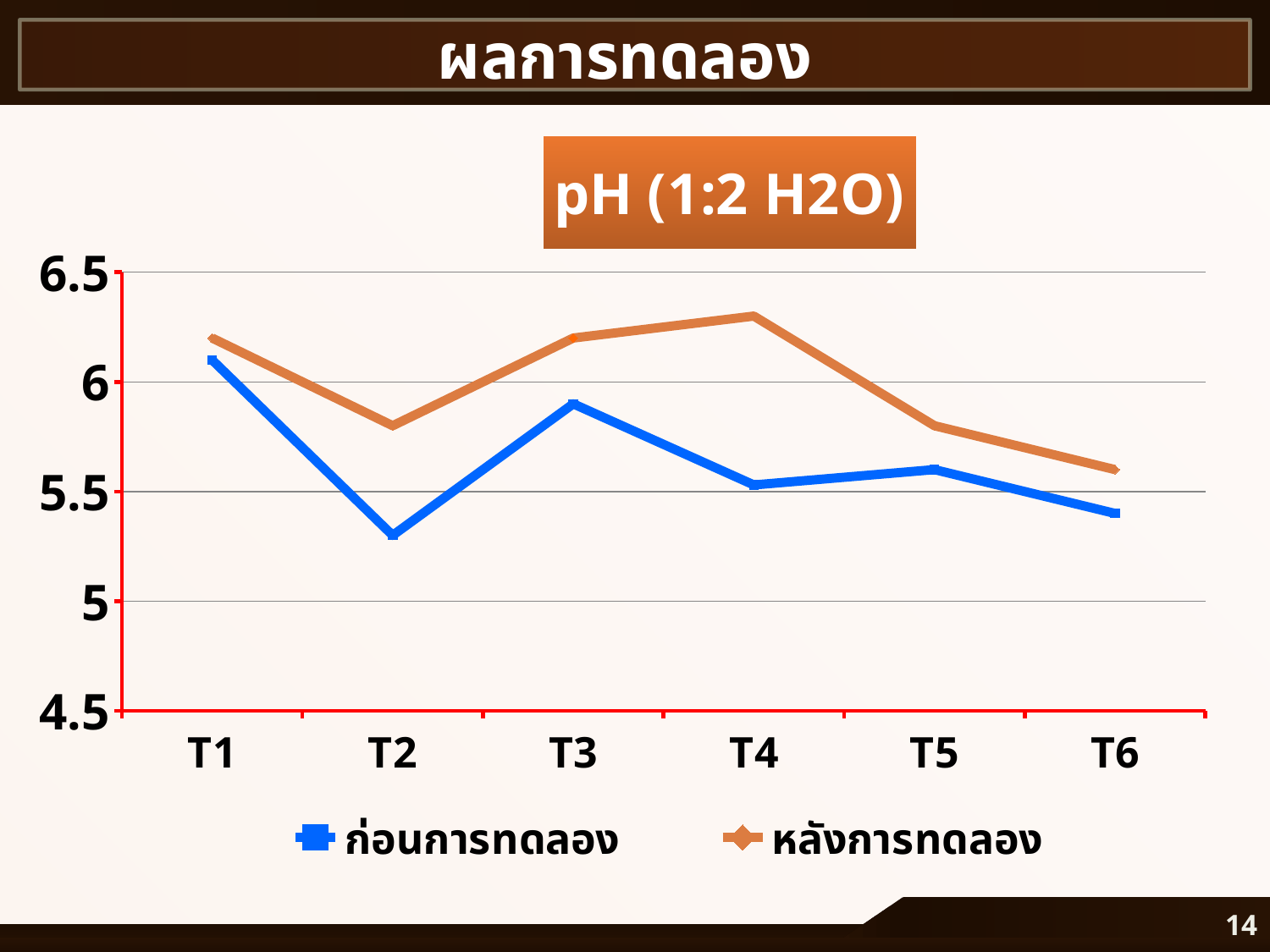
How many series does the legend list? 2 Which category has the lowest value for หลังการทดลอง? T6 Is the value for ก่อนการทดลอง at T2 greater or less than 5.5? less How many categories are shown on the x axis? 6 Is the value for หลังการทดลอง at T4 greater or less than 6? greater Does the value for หลังการทดลอง rise or fall from T4 to T6? fall What is the title of the chart? pH (1:2 H2O) What kind of chart is shown on the slide? line chart Is the value for ก่อนการทดลอง at T1 greater or less than 6? greater At T4, which series has the larger value, ก่อนการทดลอง or หลังการทดลอง? หลังการทดลอง Which category has the highest value for ก่อนการทดลอง? T1 Which category has the lowest value for ก่อนการทดลอง? T2